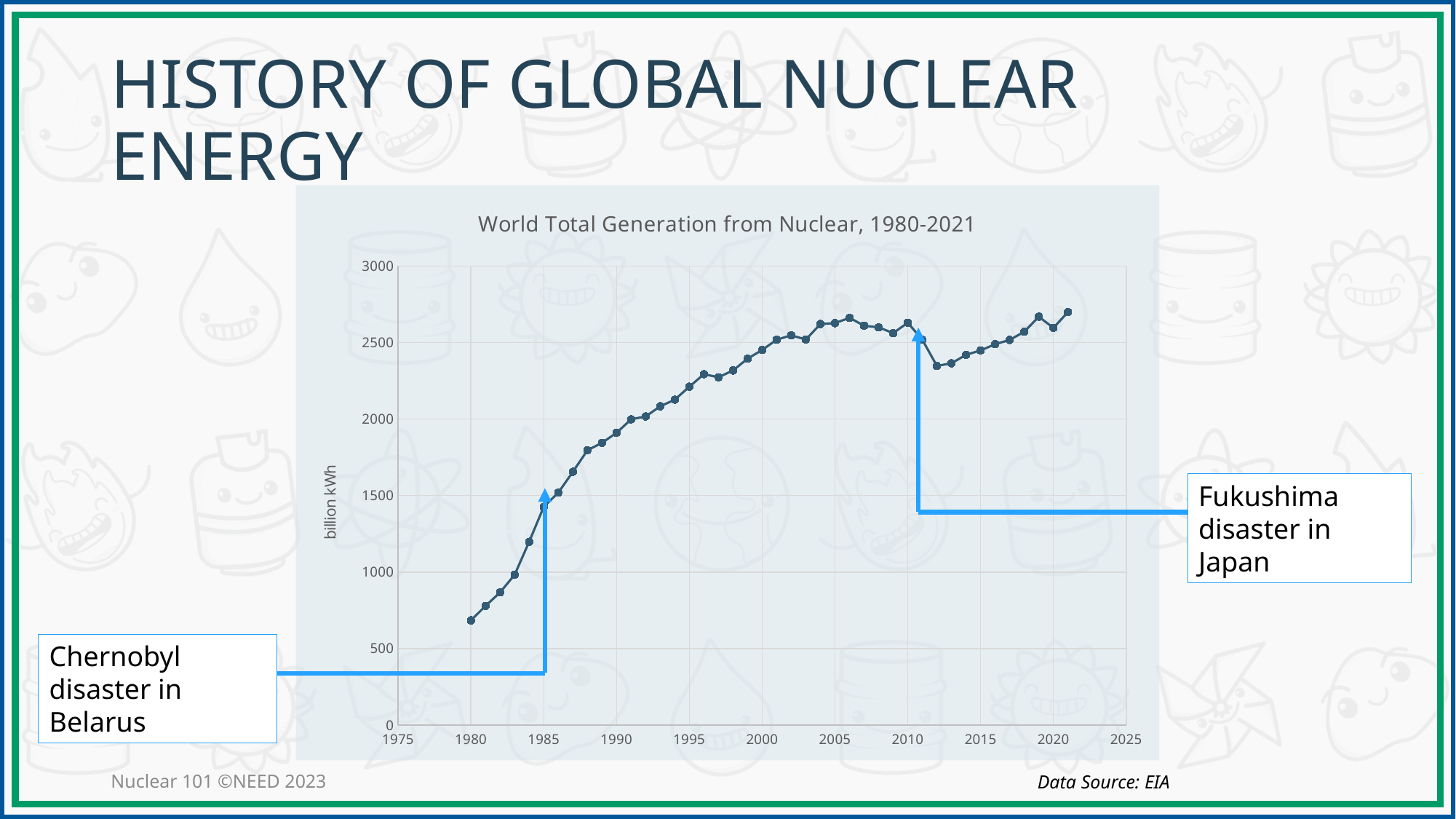
What kind of chart is shown on the slide? line chart Which year has the lowest value on the chart? 1980 Which is larger, the value for 2010 or the value for 2012? 2010 Is the value for 2012 greater or less than 2500? less Which is larger, the value for 1995 or the value for 2005? 2005 What is the title of the chart? World Total Generation from Nuclear, 1980-2021 Is the value for 2005 greater or less than 2500? greater Is the value for 1980 greater or less than 1000? less Do the values rise or fall between 1980 and 2005? rise What unit is shown on the y-axis of the chart? billion kWh